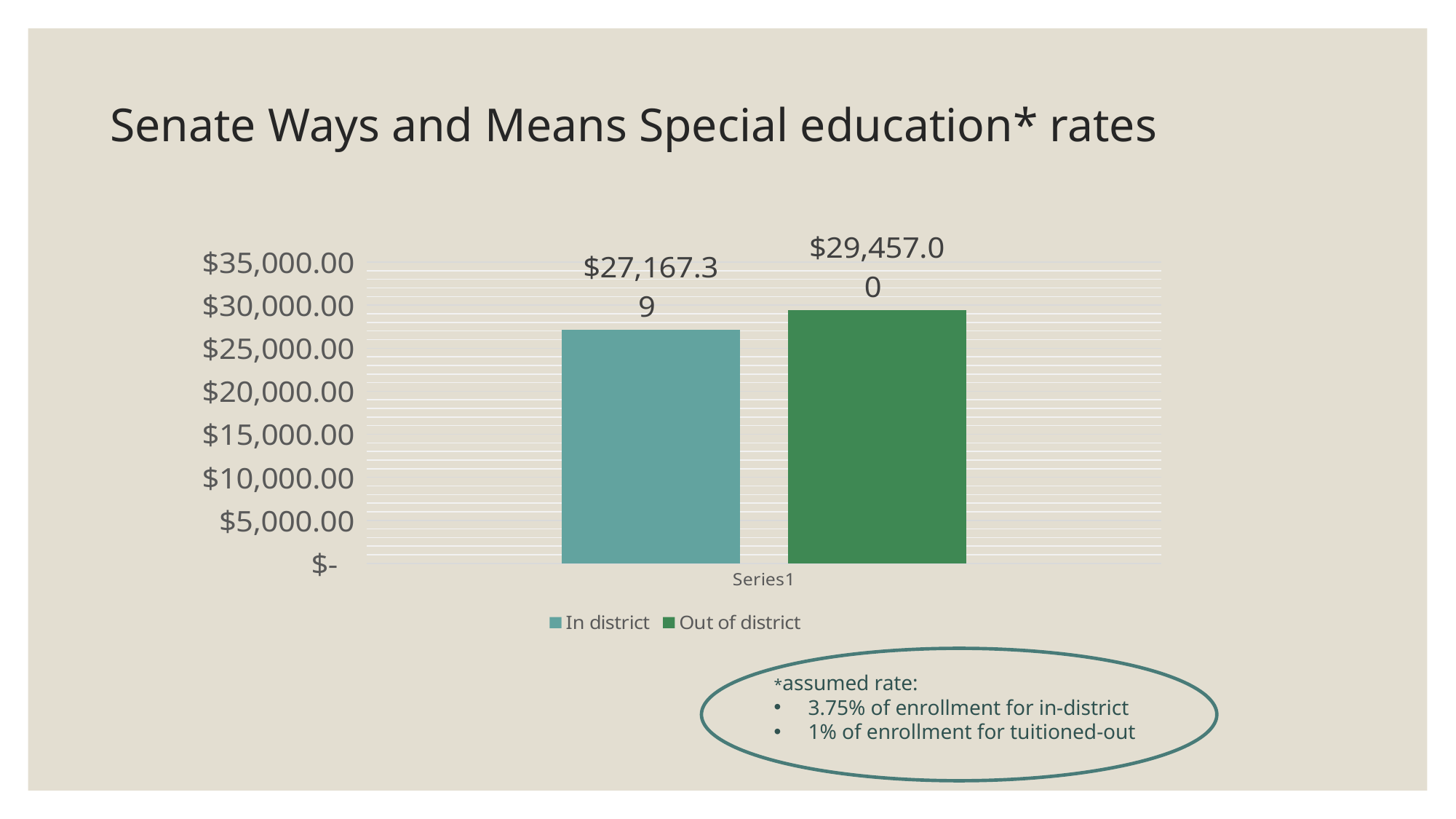
What is the value for In district? $27,167.39 Which series has the higher value, In district or Out of district? Out of district What label appears on the category axis below the bars? Series1 What is the title of the chart on the slide? Senate Ways and Means Special education* rates How many series does the legend list? 2 Which series has the lower value? In district What is the value for Out of district? $29,457.00 Is the value for Out of district greater or less than $30,000.00? less Is the In district value larger or smaller than the Out of district value? smaller Is the value for In district greater or less than $25,000.00? greater What kind of chart is shown on the slide? bar chart What is the difference between the Out of district and In district values? $2,289.61